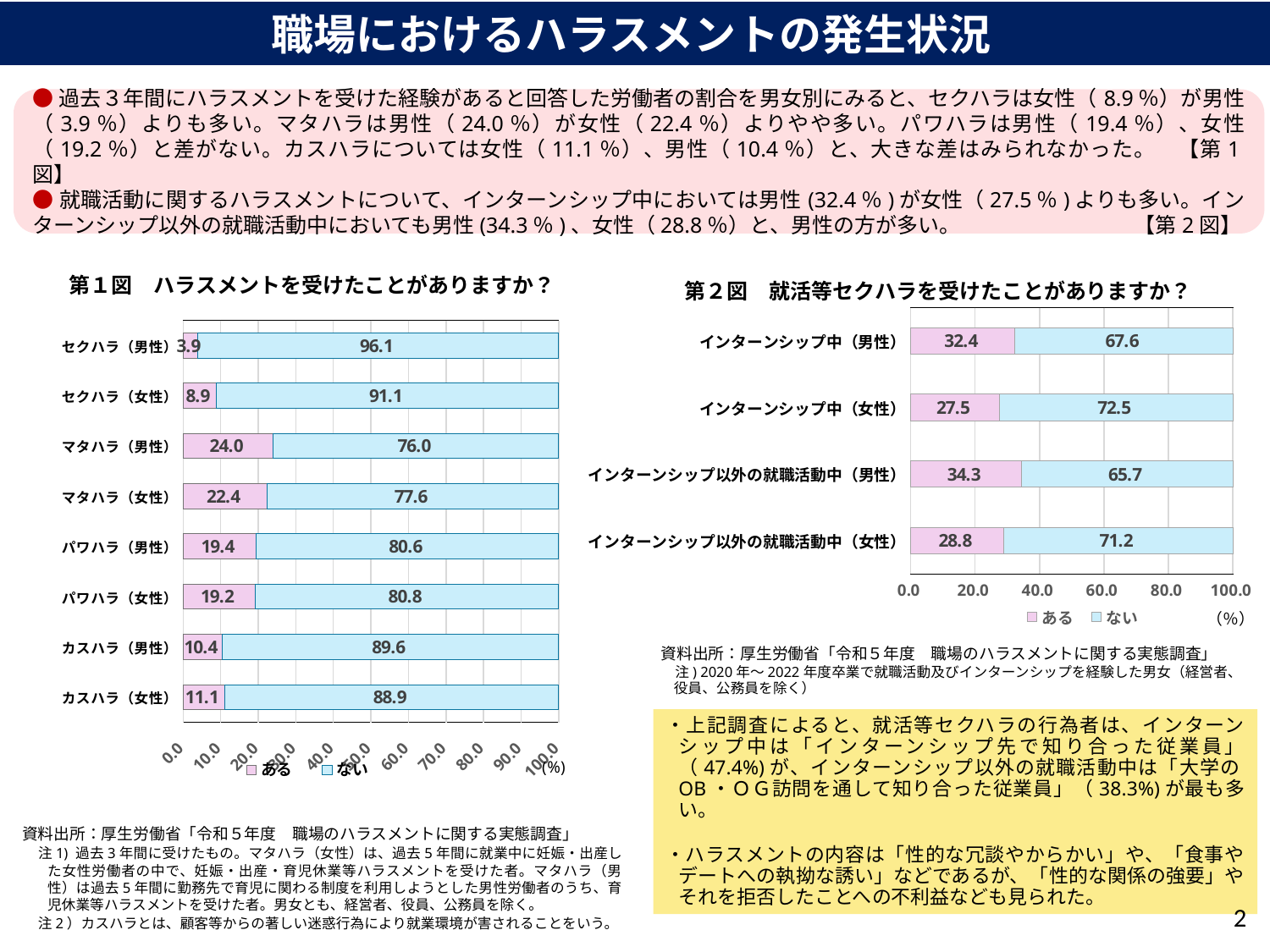
In 第2図, which category has the lowest value for ある? インターンシップ中（女性） In 第1図, what is the value of ある for マタハラ（男性）? 24.0 In 第2図, what is the difference between the ある values for インターンシップ中（男性） and インターンシップ中（女性）? 4.9 In 第1図, how many categories are shown? 8 In 第1図, which category has the highest value for ある? マタハラ（男性） In 第1図, which is larger, the ある value for カスハラ（女性） or カスハラ（男性）? カスハラ（女性） In 第1図, what is the difference between the ある values for セクハラ（女性） and セクハラ（男性）? 5.0 In 第1図, what is the value of ない for セクハラ（女性）? 91.1 What type of chart is 第2図? Stacked bar chart In 第2図, what is the value of ある for インターンシップ以外の就職活動中（男性）? 34.3 In 第2図, how many series does the legend list? 2 In 第1図, which category has the lowest value for ある? セクハラ（男性）